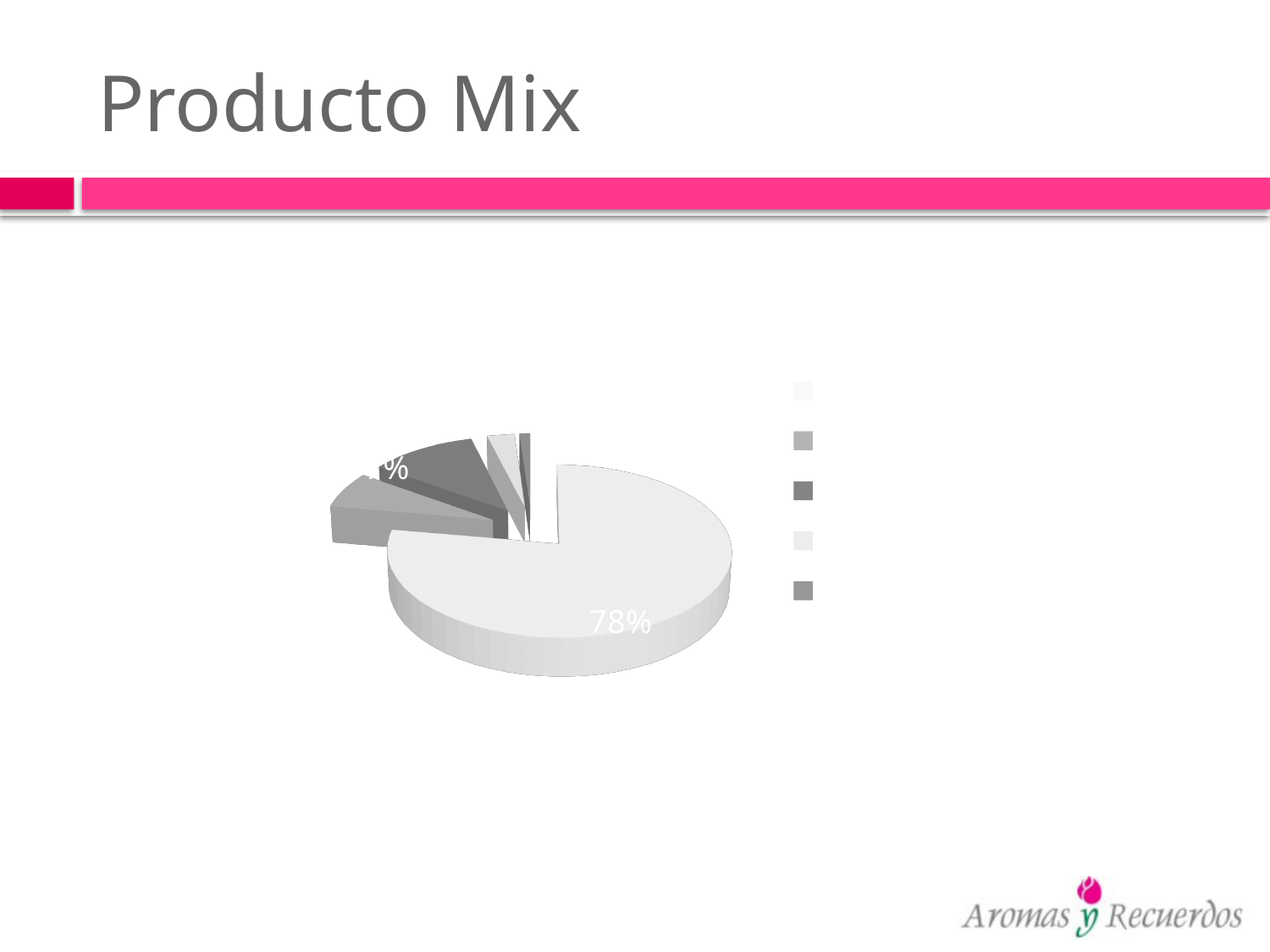
What is the title of the slide containing the chart? Producto Mix Is the largest slice of the pie chart greater or less than 50% of the total? greater What kind of chart is shown on the slide? pie chart What share of the pie does the largest slice represent? 78% How many entries does the legend of the pie chart list? 5 What percentage is printed on the largest slice of the pie chart? 78% Is the pie chart drawn in 3D or flat 2D? 3D How many slices does the pie chart have? 5